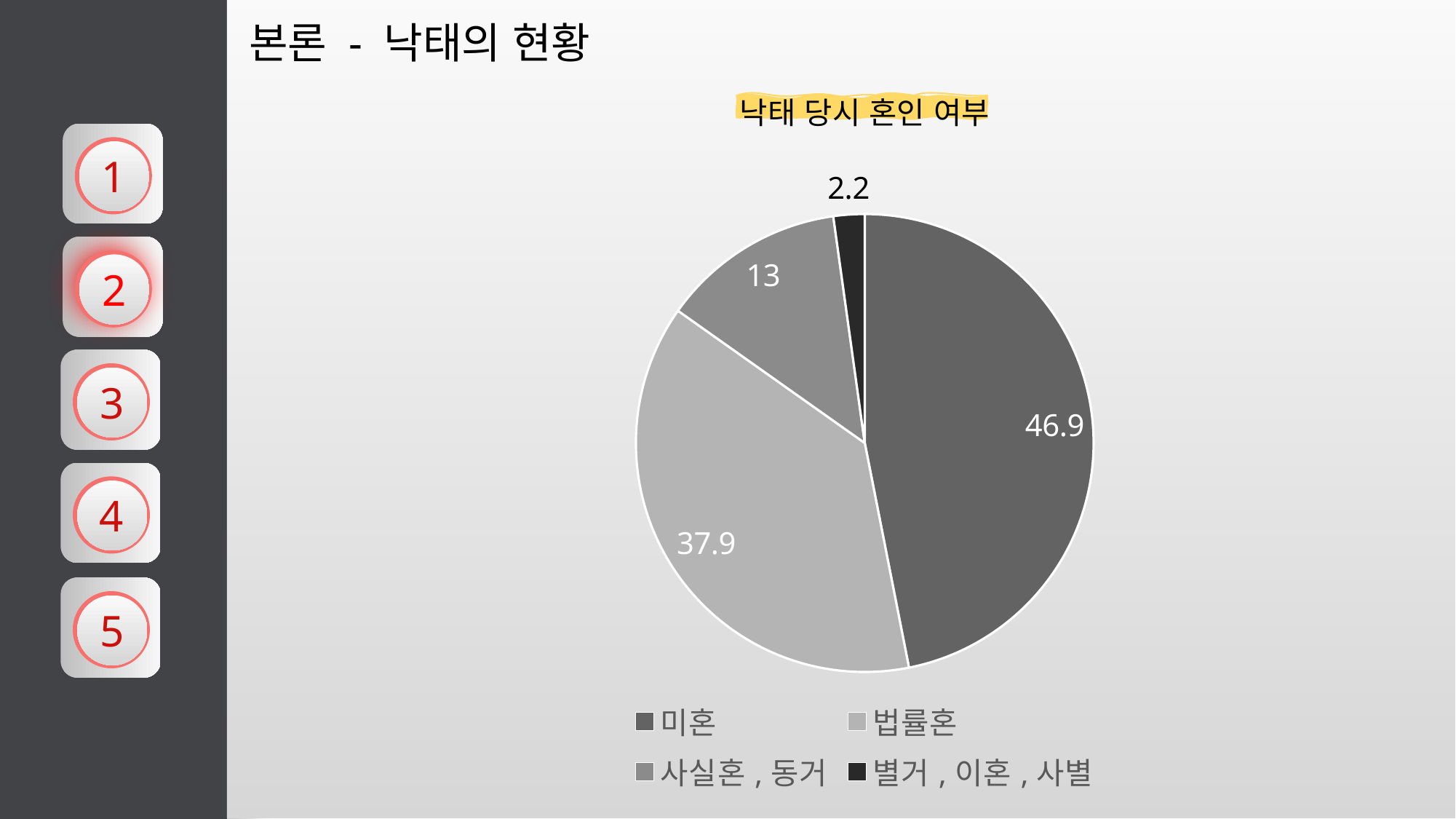
What is the difference between the values for 미혼 and 법률혼? 9 Which is larger, the value for 법률혼 or the value for 사실혼, 동거? 법률혼 What is the value for 법률혼 in the pie chart? 37.9 What is the value for 별거, 이혼, 사별 in the pie chart? 2.2 What is the total of all the values shown in the pie chart? 100 What is the value for 미혼 in the pie chart? 46.9 Which category has the smallest slice in the pie chart? 별거, 이혼, 사별 Which category has the largest slice in the pie chart? 미혼 What is the title of the pie chart? 낙태 당시 혼인 여부 What is the value for 사실혼, 동거 in the pie chart? 13 How many slices does the pie chart have? 4 What type of chart is shown on the slide? pie chart